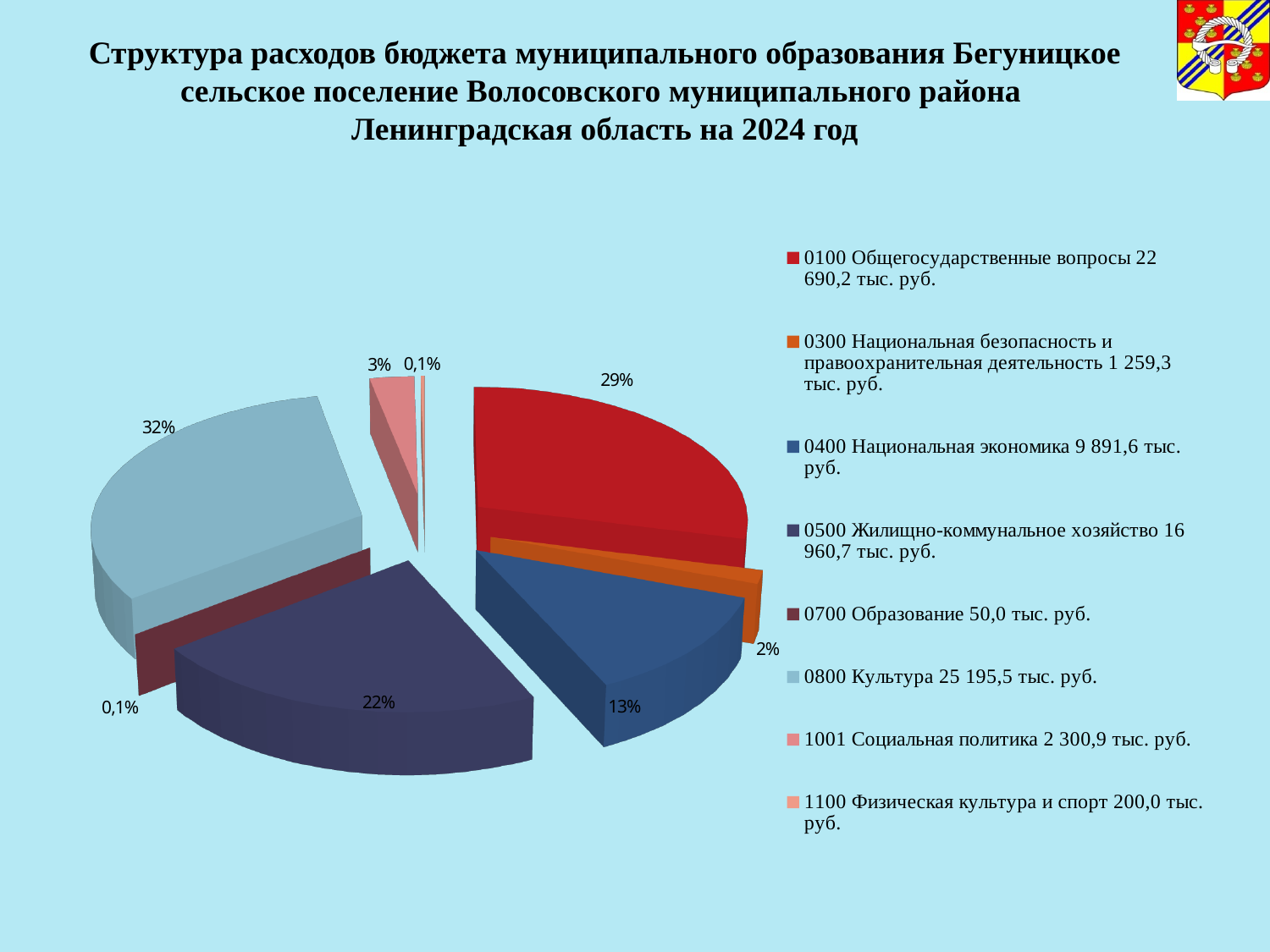
How many categories does the legend of the pie chart list? 8 What is the difference in percentage points between the share for 0800 Культура and the share for 0100 Общегосударственные вопросы? 3 percentage points What share of the pie does 0500 Жилищно-коммунальное хозяйство take? 22% What share of the pie does 0100 Общегосударственные вопросы take? 29% What kind of chart is shown on the slide? pie chart What is the amount shown in the legend for 0400 Национальная экономика? 9 891,6 тыс. руб. Which category has the largest slice of the pie? 0800 Культура What is the amount shown in the legend for 1001 Социальная политика? 2 300,9 тыс. руб. What share of the pie does 0400 Национальная экономика take? 13% Which is larger, the share for 0500 Жилищно-коммунальное хозяйство or the share for 0400 Национальная экономика? 0500 Жилищно-коммунальное хозяйство What is the amount shown in the legend for 0700 Образование? 50,0 тыс. руб.